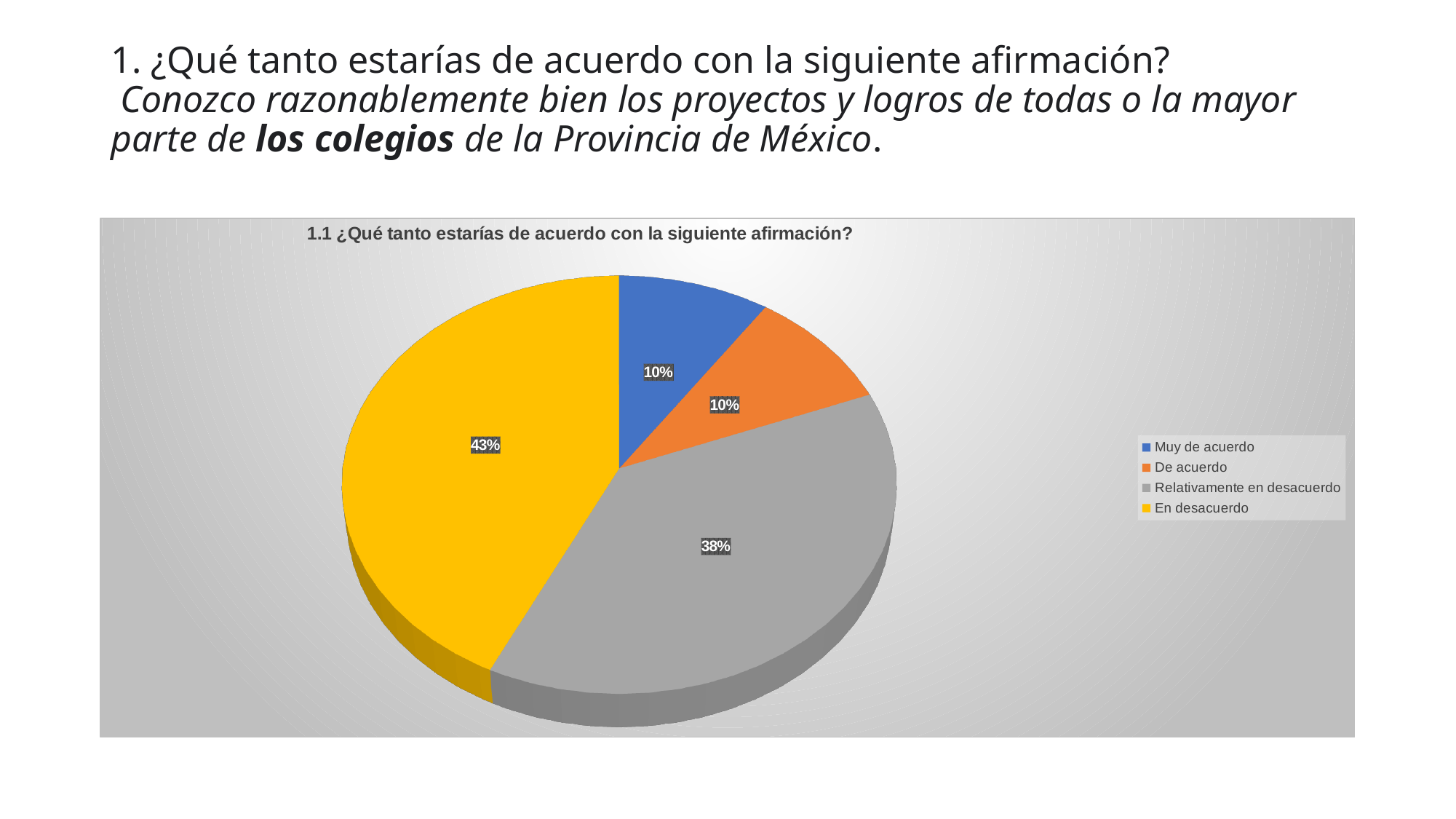
What percentage of respondents answered "Muy de acuerdo"? 10% What percentage of respondents answered "Relativamente en desacuerdo"? 38% How many categories does the legend list? 4 What is the title of the chart? 1.1 ¿Qué tanto estarías de acuerdo con la siguiente afirmación? What is the combined percentage of "Muy de acuerdo" and "De acuerdo"? 20% What percentage of respondents answered "En desacuerdo"? 43% Which is larger: the share for "Relativamente en desacuerdo" or the share for "De acuerdo"? Relativamente en desacuerdo What percentage of respondents answered "De acuerdo"? 10% What kind of chart is shown on the slide? Pie chart What colour is the slice for "En desacuerdo"? Yellow What is the difference in percentage points between "En desacuerdo" and "Relativamente en desacuerdo"? 5 Which response category has the largest share of the pie? En desacuerdo